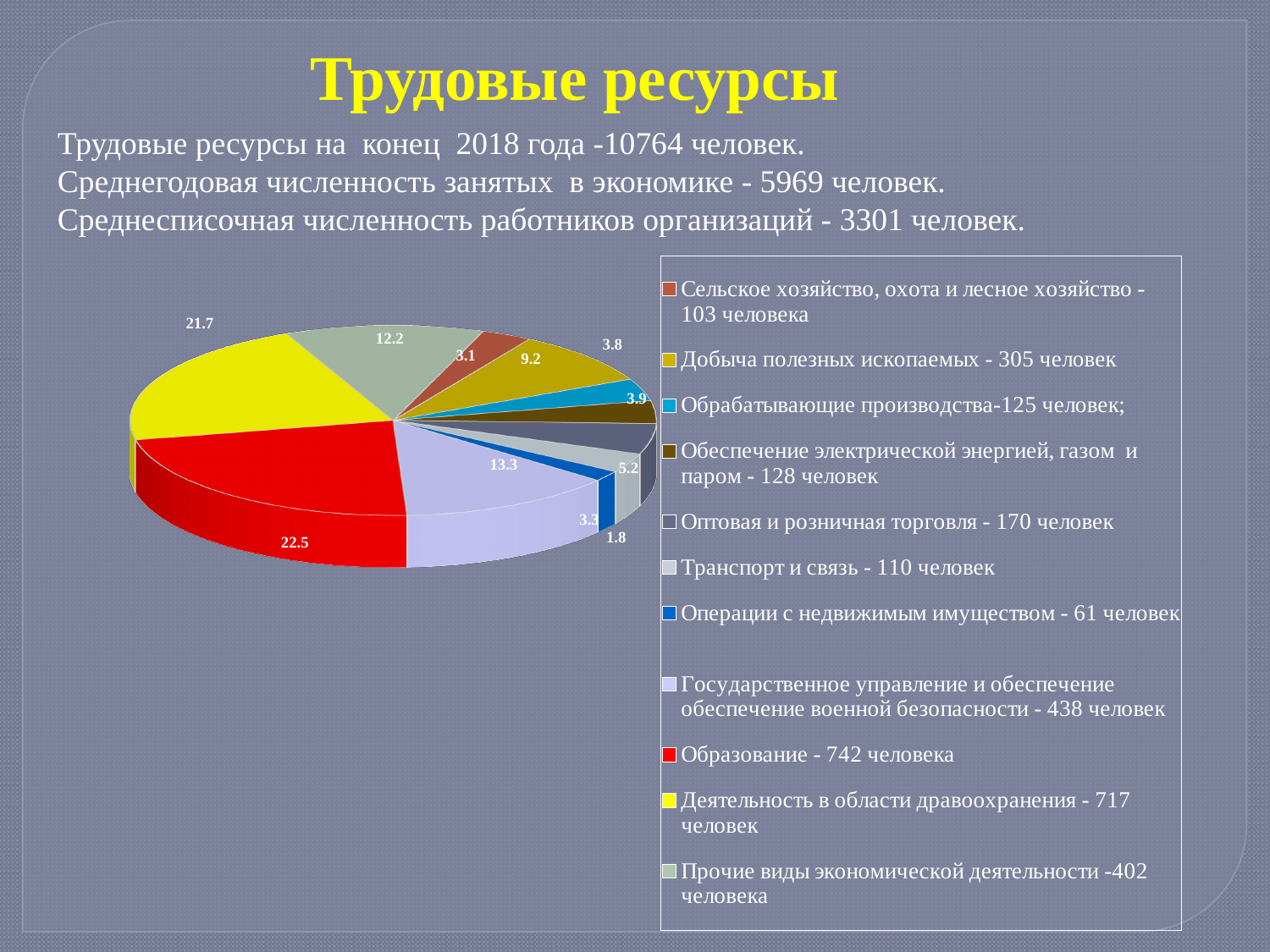
Which slice is larger: Государственное управление и обеспечение военной безопасности or Прочие виды экономической деятельности? Государственное управление и обеспечение военной безопасности What kind of chart is shown on the slide? Pie chart According to the legend, how many people are in Образование? 742 человека What value is labelled on the slice for Деятельность в области здравоохранения? 21.7 According to the legend, how many people are in Добыча полезных ископаемых? 305 человек What value is labelled on the slice for Прочие виды экономической деятельности? 12.2 How many categories (slices) does the pie chart have? 11 What value is labelled on the slice for Образование? 22.5 What value is labelled on the slice for Государственное управление и обеспечение военной безопасности? 13.3 Which category has the smallest slice in the pie chart? Операции с недвижимым имуществом What is the difference between the labelled values for Образование and Деятельность в области здравоохранения? 0.8 Which category has the largest slice in the pie chart? Образование